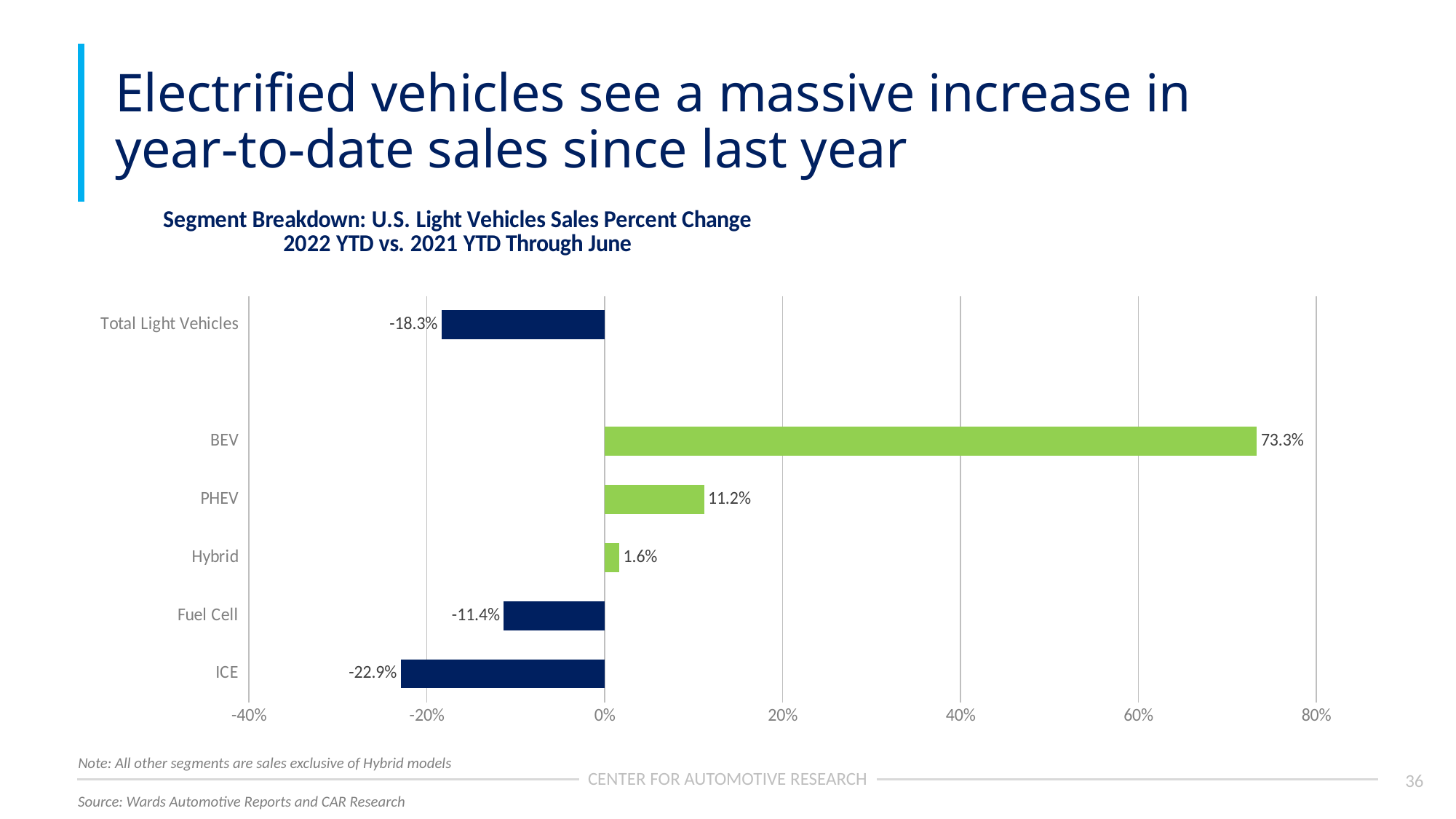
What is the percent change for Fuel Cell? -11.4% What is the percent change for BEV? 73.3% What is the title of the chart? Segment Breakdown: U.S. Light Vehicles Sales Percent Change 2022 YTD vs. 2021 YTD Through June What is the difference between the percent change for BEV and PHEV? 62.1% How many categories are shown in the chart? 6 What is the percent change for Total Light Vehicles? -18.3% What kind of chart is shown on the slide? Bar chart Which category has the lowest percent change? ICE Which category has the highest percent change? BEV Which has a larger percent change, PHEV or Hybrid? PHEV Is the value for BEV greater or less than 60%? greater What is the percent change for ICE? -22.9%